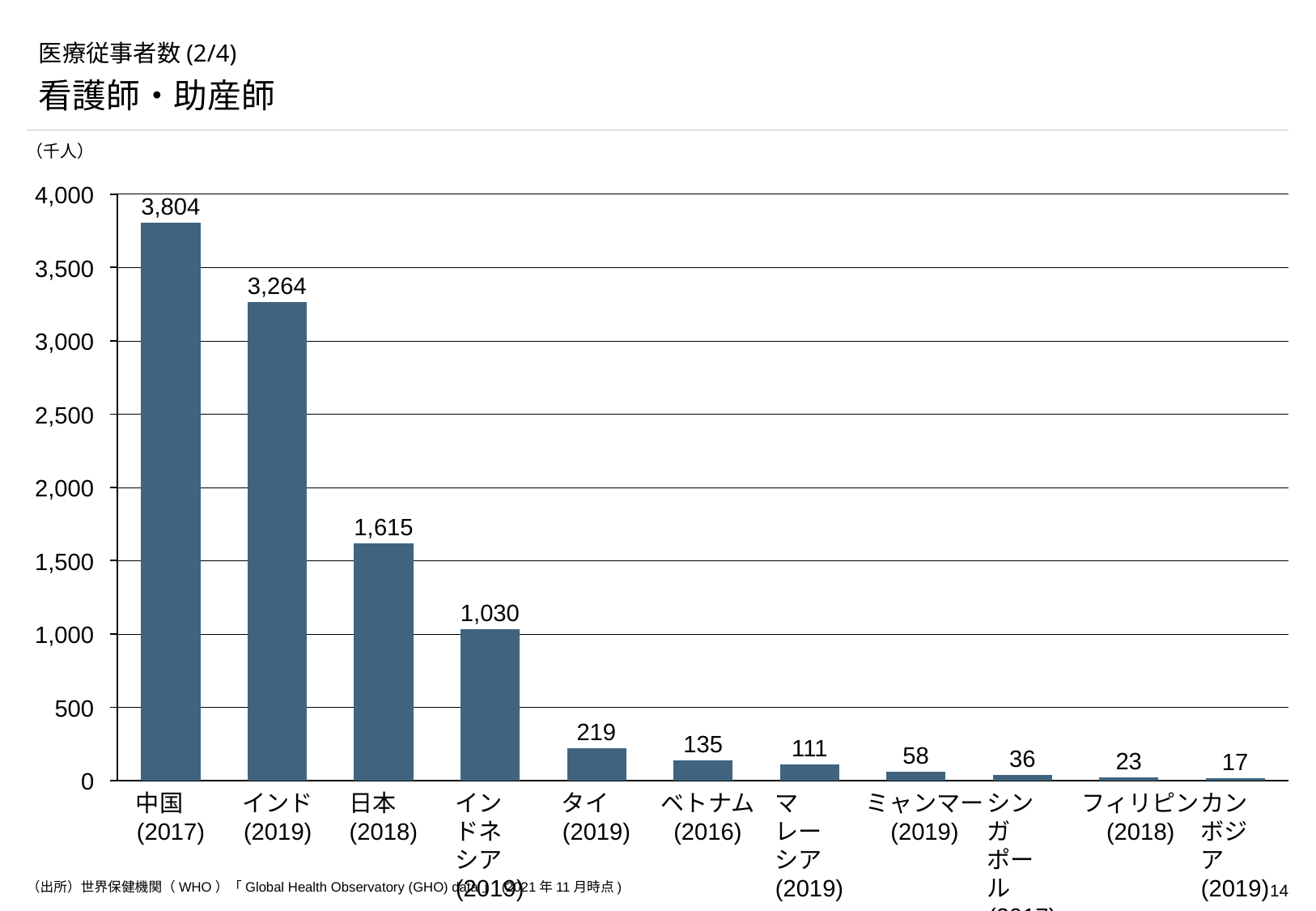
グラフの単位は何ですか？ 千人 最も値が大きい国はどこですか？ 中国 ベトナム（2016）の値はいくつですか？ 135 日本とインドネシアの値の差はいくつですか？ 585 最も値が小さい国はどこですか？ カンボジア このグラフには国がいくつ表示されていますか？ 11 インドの値は3,000より大きいですか、小さいですか？ 大きい 中国とインドの値の差はいくつですか？ 540 中国（2017）の看護師・助産師数は何千人ですか？ 3,804 これはどの種類のグラフですか？ 棒グラフ タイとマレーシアでは、どちらの値が大きいですか？ タイ 日本（2018）の値はいくつですか？ 1,615